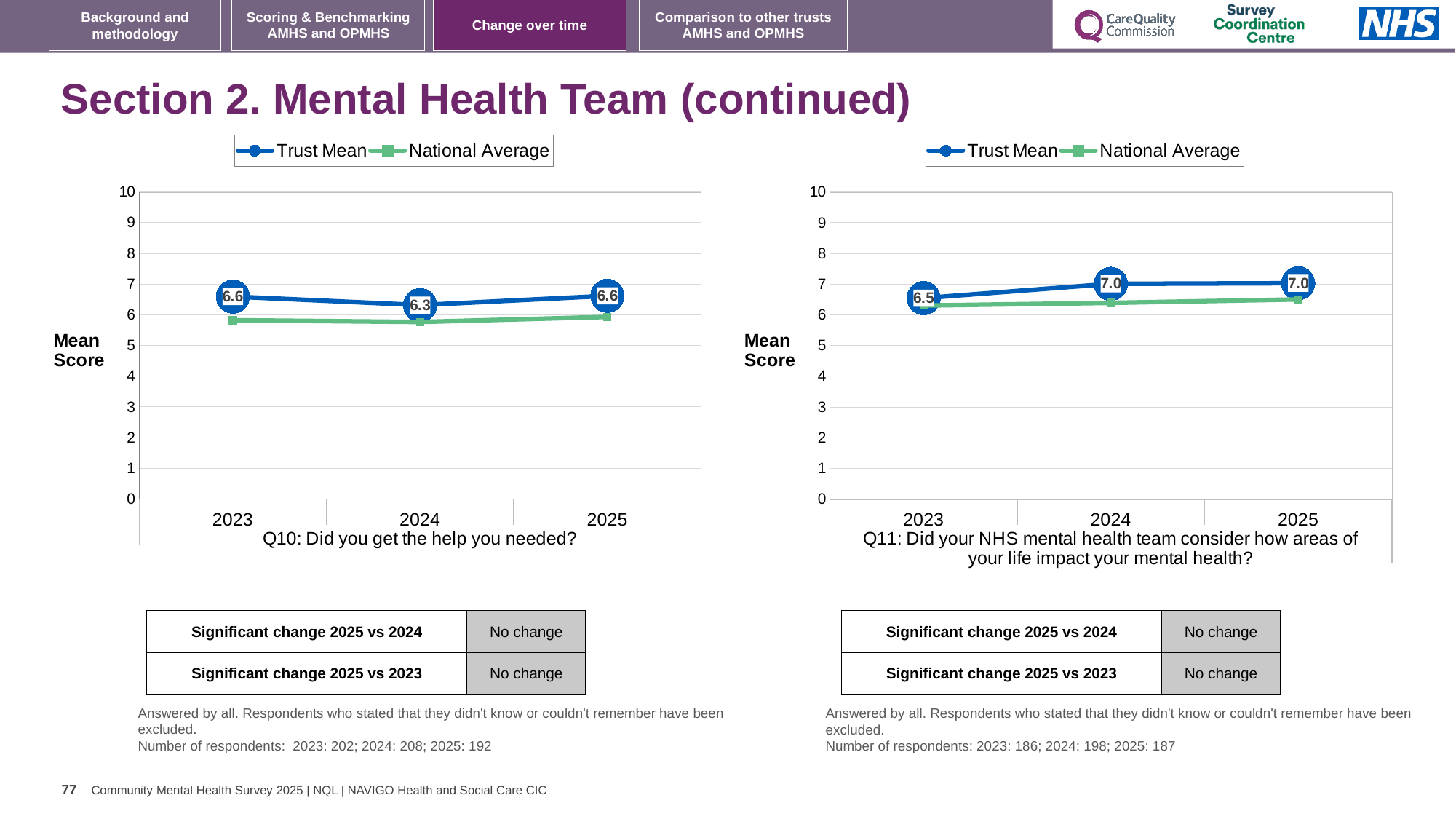
How many years are plotted on the x axis of the Q11 chart? 3 In the Q11 chart, what is the Trust Mean score for 2025? 7.0 What type of chart is used for Q11? Line chart In the Q11 chart, what is the Trust Mean score for 2023? 6.5 In the Q10 chart, what is the Trust Mean score for 2024? 6.3 In the Q10 chart, what is the Trust Mean score for 2025? 6.6 In the Q10 chart, which year has the lowest Trust Mean score? 2024 In the Q10 chart, is the National Average value for 2025 greater or less than 5? greater In the Q10 chart, is the Trust Mean score for 2023 larger or smaller than the Trust Mean score for 2024? larger In the Q11 chart, what is the difference between the Trust Mean score in 2025 and in 2023? 0.5 In the Q11 chart, is the National Average value for 2023 greater or less than 7? less How many series does the legend of the Q10 chart list? 2